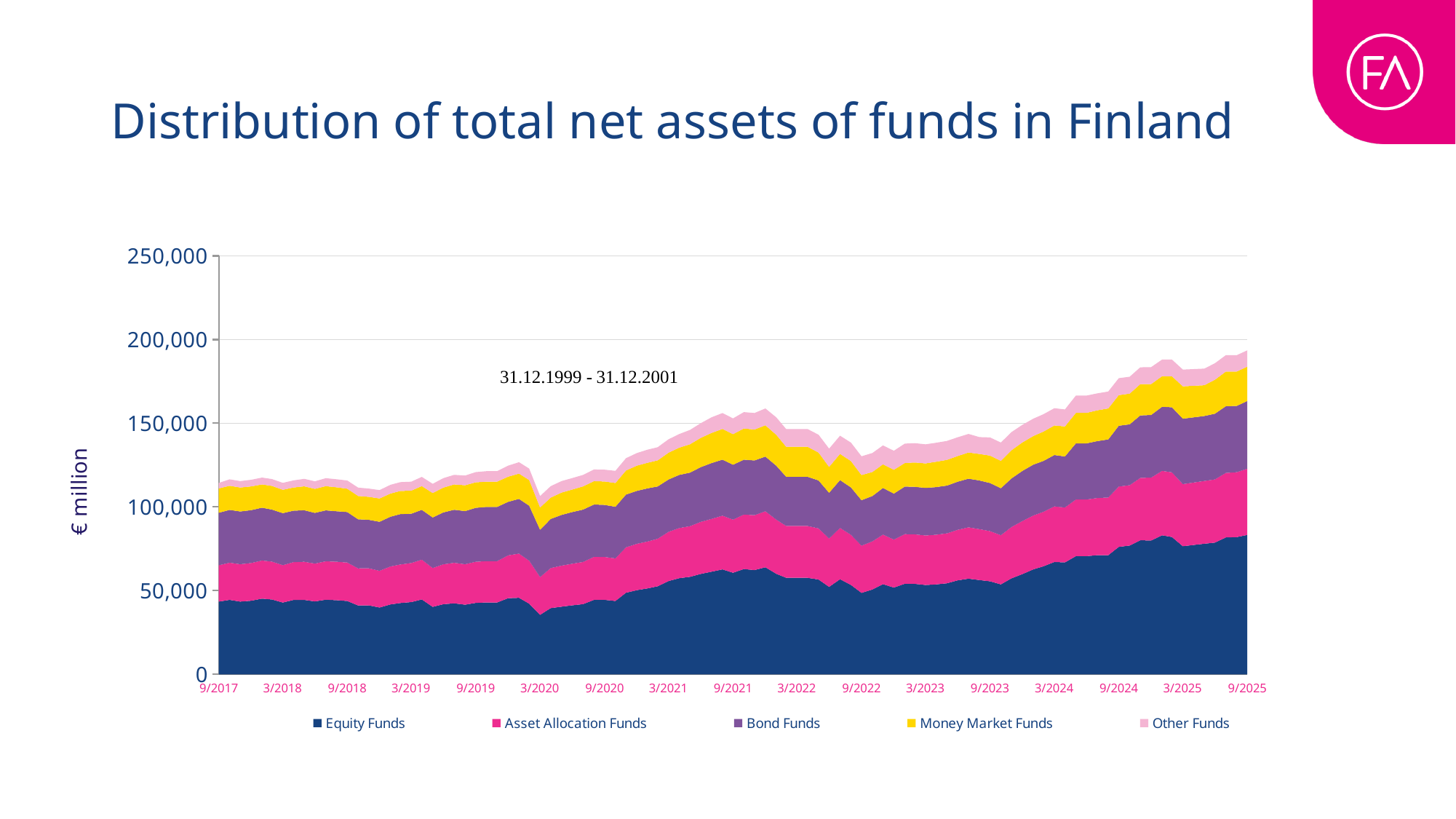
Is the total net assets value at 9/2022 greater or less than 150,000? less What kind of chart is shown on the slide? Stacked area chart Is the total net assets value at 9/2017 greater or less than 100,000? greater What unit is shown on the vertical axis label? € million How many date labels are shown along the x axis? 17 Is the Equity Funds value at 9/2025 greater or less than 100,000? less What is the title of the chart? Distribution of total net assets of funds in Finland Do total net assets generally rise or fall from 9/2017 to 9/2025? Rise At which x-axis date is the total net assets value highest? 9/2025 How many series does the legend list? 5